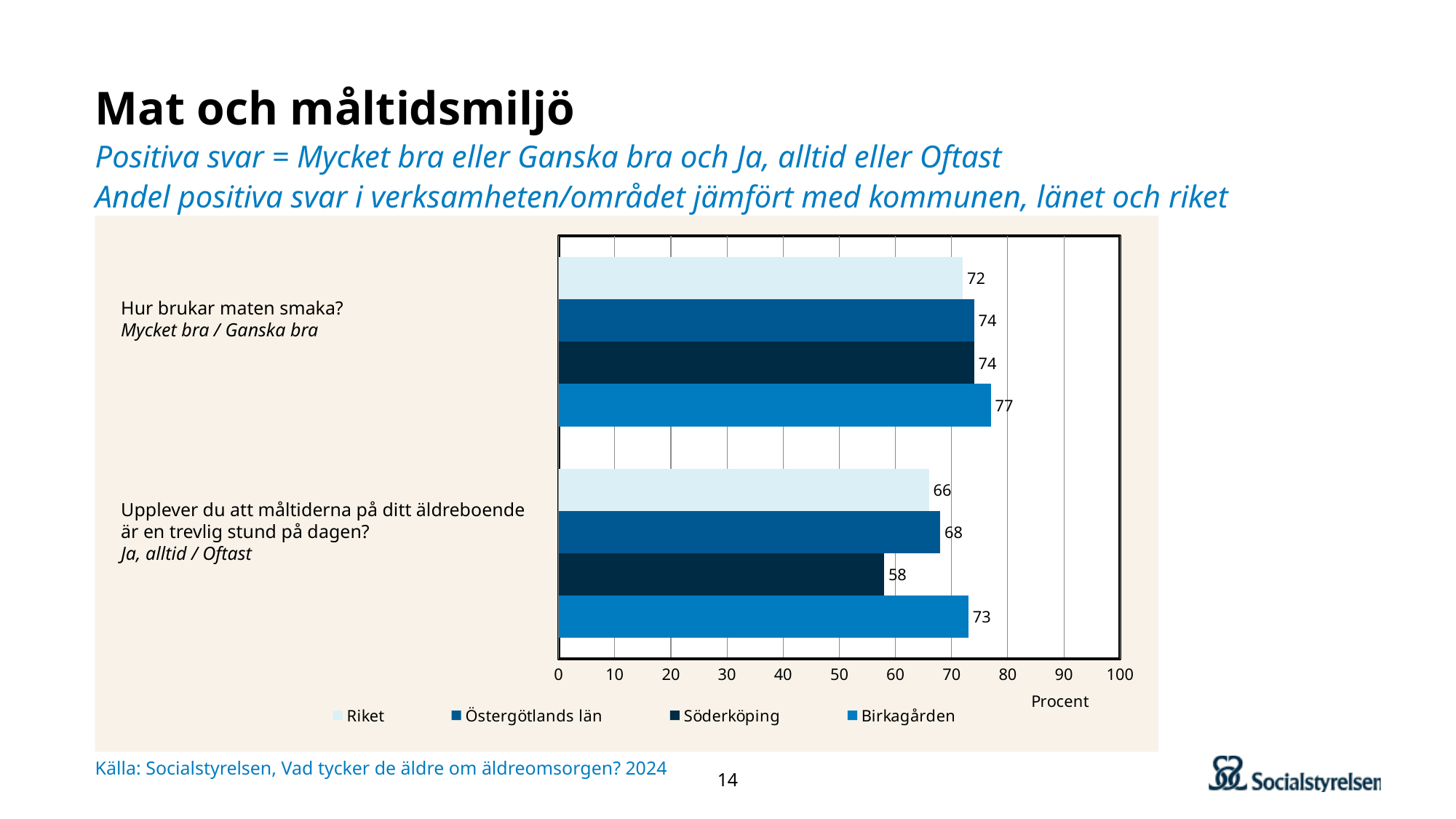
What is the difference between Birkagården and Riket on "Hur brukar maten smaka?"? 5 Which series has the highest value on "Hur brukar maten smaka?"? Birkagården What is the value for Birkagården on "Hur brukar maten smaka?"? 77 What is the value for Riket on "Hur brukar maten smaka?"? 72 Which is larger on "Upplever du att måltiderna på ditt äldreboende är en trevlig stund på dagen?": Riket or Birkagården? Birkagården What kind of chart is shown on the slide? Bar chart Which series has the lowest value on "Upplever du att måltiderna på ditt äldreboende är en trevlig stund på dagen?"? Söderköping How many series does the legend list? 4 What unit is shown on the x axis of the chart? Procent What is the value for Söderköping on "Upplever du att måltiderna på ditt äldreboende är en trevlig stund på dagen?"? 58 What is the difference between Birkagården and Söderköping on "Upplever du att måltiderna på ditt äldreboende är en trevlig stund på dagen?"? 15 What is the value for Östergötlands län on "Upplever du att måltiderna på ditt äldreboende är en trevlig stund på dagen?"? 68